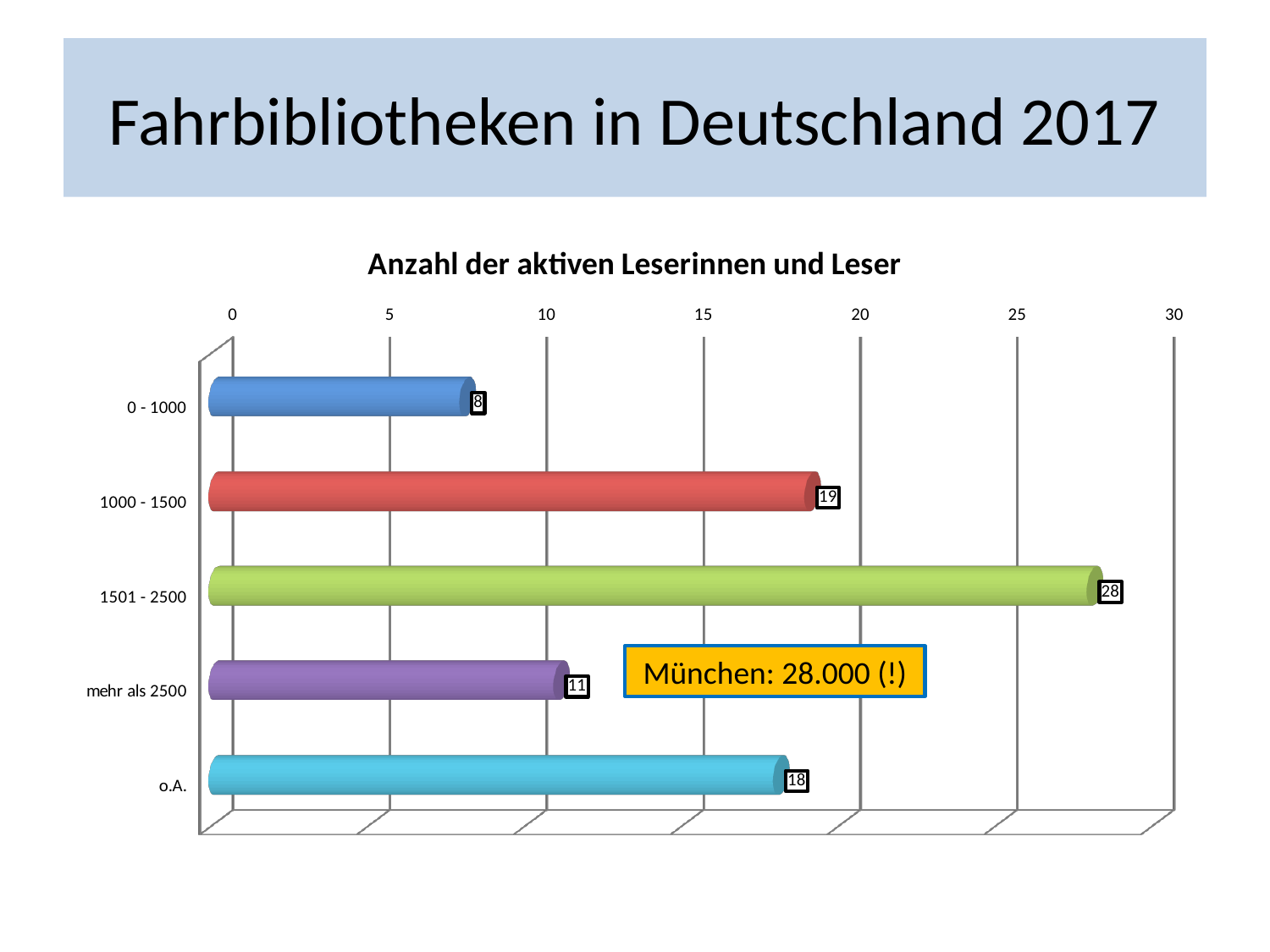
What is the value for the category "mehr als 2500"? 11 Which is larger, the value for "1000 - 1500" or the value for "o.A."? 1000 - 1500 Which category has the lowest value? 0 - 1000 What is the difference between the values for "1501 - 2500" and "1000 - 1500"? 9 What is the value for the category "1000 - 1500"? 19 What is the value for the category "o.A."? 18 What is the value for the category "1501 - 2500"? 28 What is the value for the category "0 - 1000"? 8 Which category has the highest value? 1501 - 2500 What kind of chart is shown on the slide? bar chart What is the title of the chart? Anzahl der aktiven Leserinnen und Leser How many categories are shown in the chart? 5